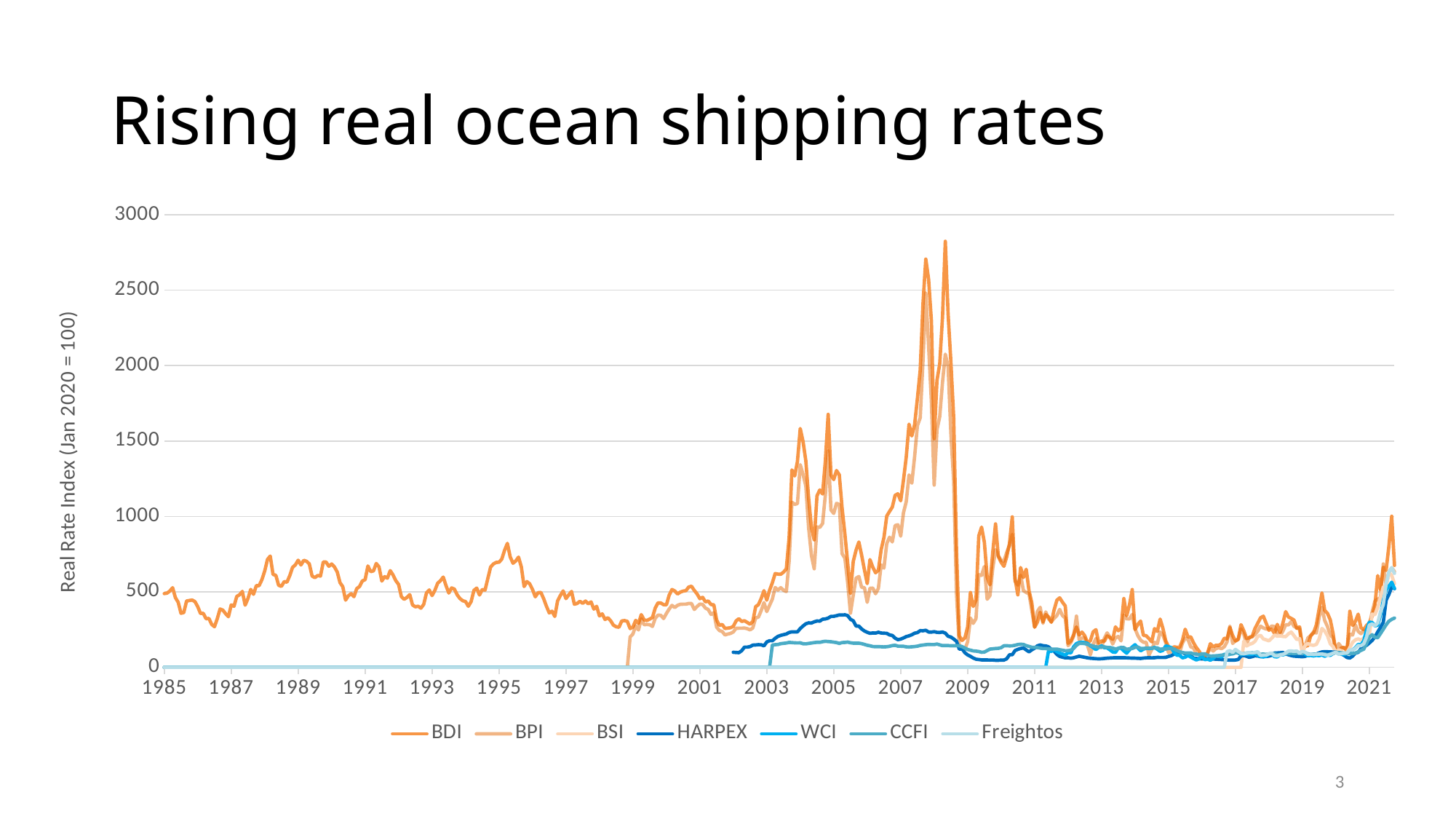
What is the label on the vertical axis? Real Rate Index (Jan 2020 = 100) Which series reaches the highest value anywhere on the chart? BDI Is the peak value of BDI around 2008 greater or less than 3000? less Is the peak value of HARPEX around 2005 greater or less than 500? less Is the value of BDI at the start of 1985 greater or less than 1000? less How many series does the legend list? 7 What is the title of the slide's chart? Rising real ocean shipping rates What is the first year shown on the horizontal axis? 1985 Between 2019 and the end of the chart in 2021, do the series generally rise or fall? rise What kind of chart is shown on the slide? line chart